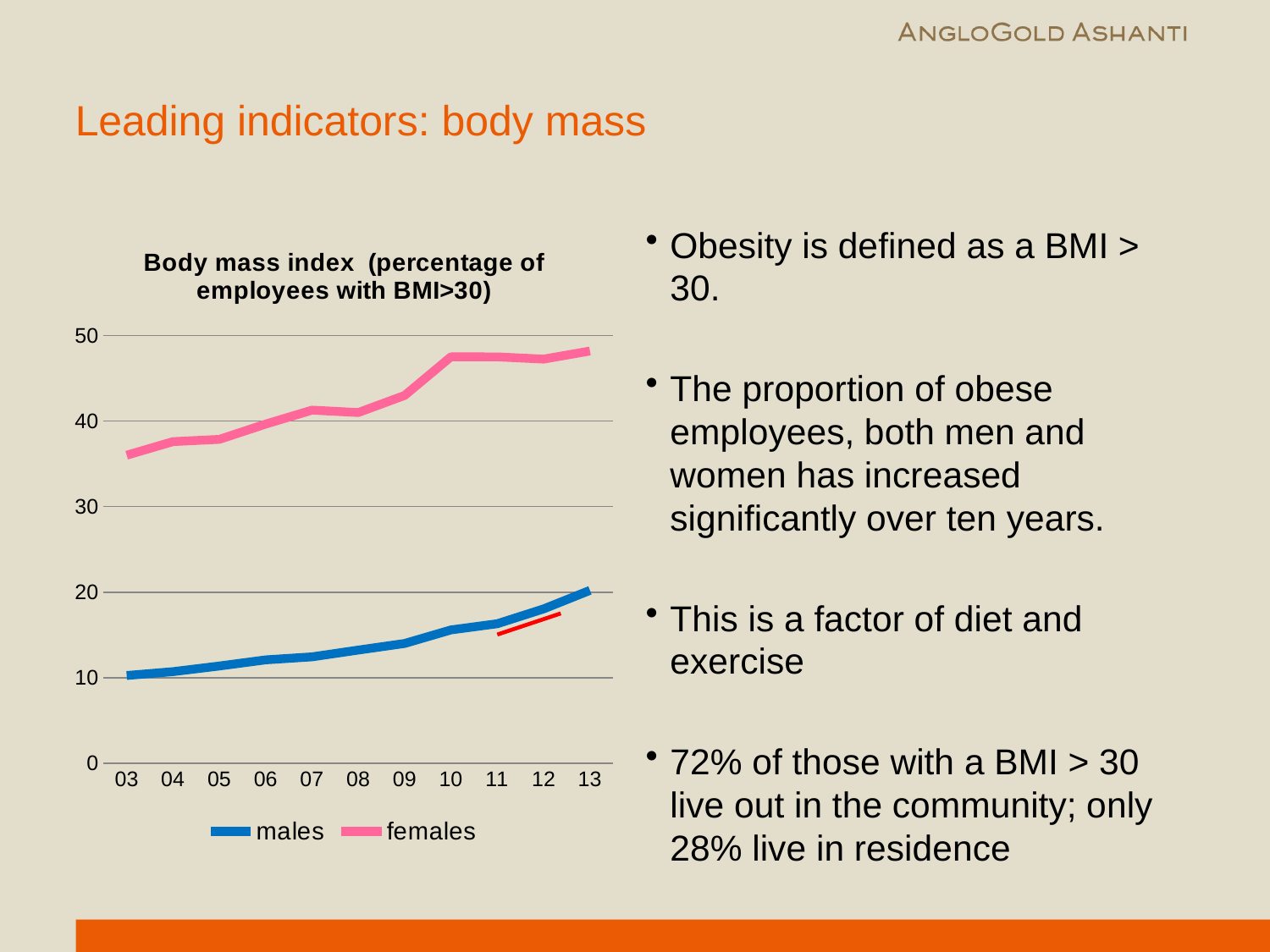
How many years are shown along the x axis? 11 Is the value for males in 13 greater or less than 10? greater Do the values for males rise or fall from 03 to 13? rise How many series does the legend list? 2 Which colour represents the males series in the legend? blue Which series has the larger value in 13, males or females? females Do the values for females rise or fall from 03 to 13? rise Is the value for females in 03 greater or less than 30? greater Is the value for males in 10 greater or less than 20? less What is the title of the chart? Body mass index (percentage of employees with BMI>30) What kind of chart is shown on the slide? line chart